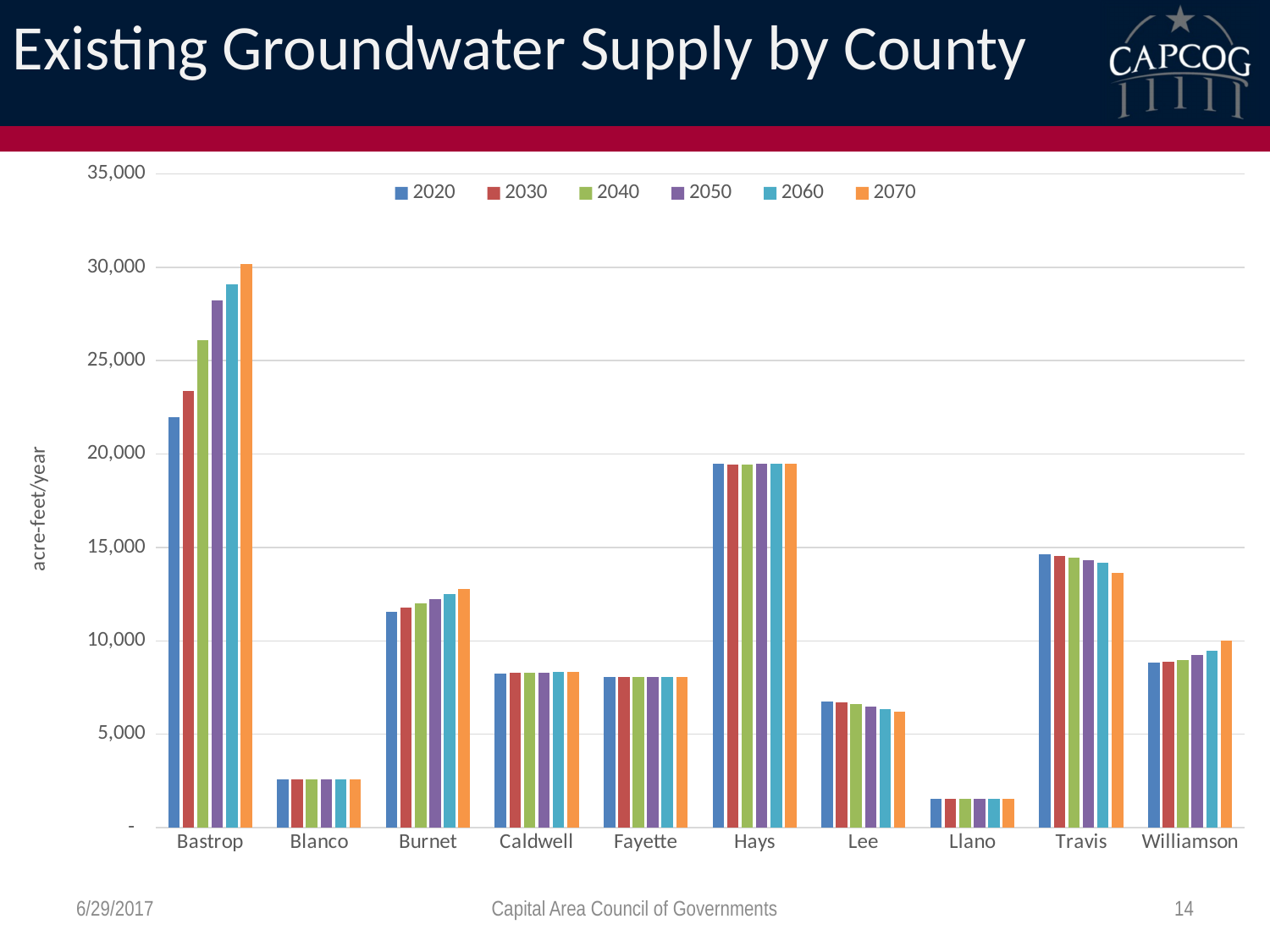
How many counties are shown on the x axis? 10 Is the 2020 value for Burnet greater or less than 10,000? greater What kind of chart is shown on the slide? bar chart What is the label on the y axis? acre-feet/year Which county has the lowest groundwater supply in 2020? Llano Do the values for Travis rise or fall from 2020 to 2070? fall Which county has the highest groundwater supply in 2070? Bastrop Is the 2070 value for Bastrop greater or less than 30,000? greater How many series does the legend list? 6 Is the 2020 value for Hays greater or less than 20,000? less Do the values for Bastrop rise or fall from 2020 to 2070? rise Which is larger, the 2020 value for Travis or the 2020 value for Williamson? Travis